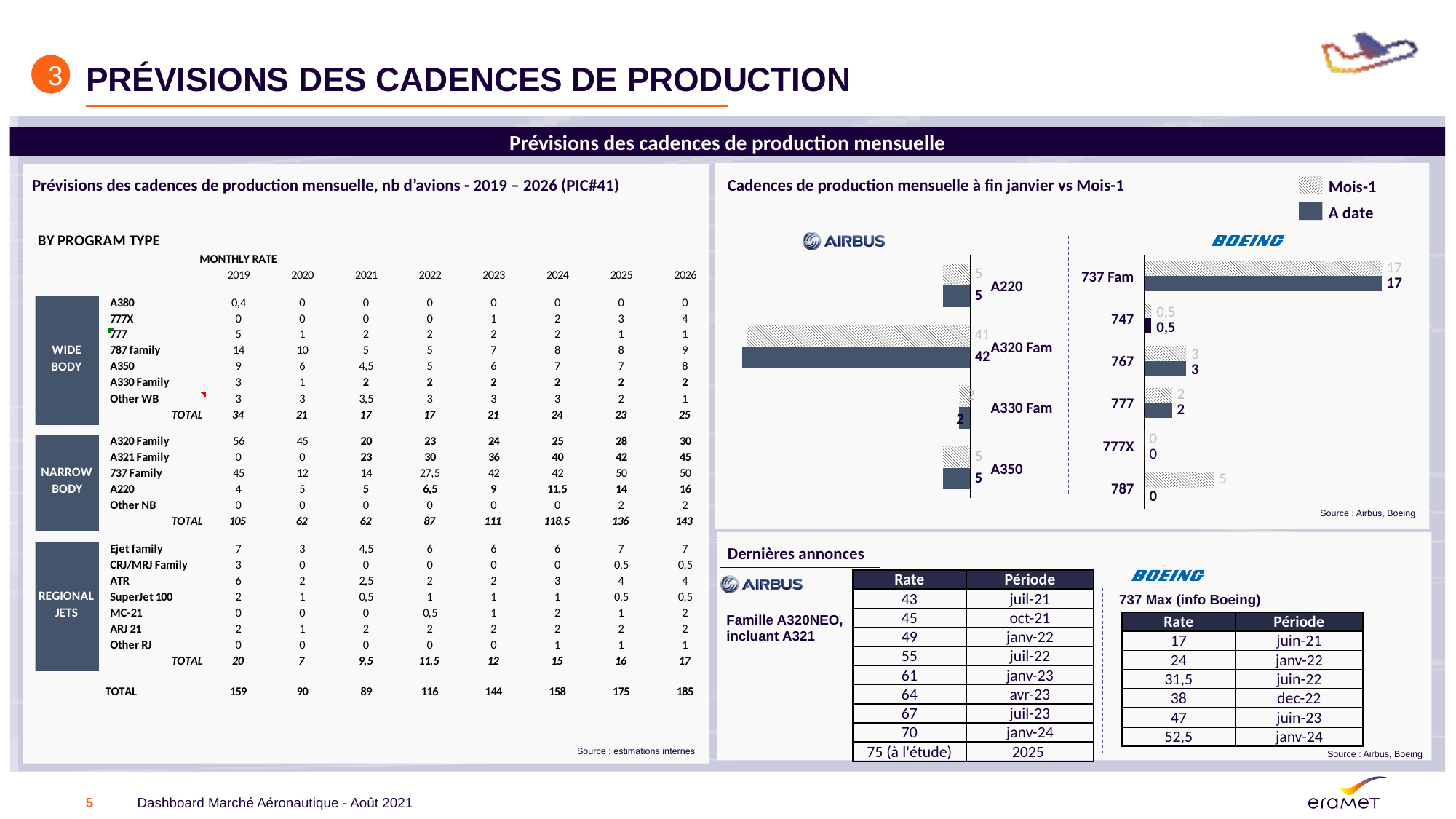
In the chart 'Cadences de production mensuelle à fin janvier vs Mois-1', how many series does the legend list? 2 In the chart 'Cadences de production mensuelle à fin janvier vs Mois-1', what is the 'A date' value for A320 Fam? 42 In the chart 'Cadences de production mensuelle à fin janvier vs Mois-1', what is the 'A date' value for 737 Fam? 17 In the chart 'Cadences de production mensuelle à fin janvier vs Mois-1', how many Boeing programs are shown? 6 In the chart 'Cadences de production mensuelle à fin janvier vs Mois-1', what is the difference between the 'A date' and 'Mois-1' values for A320 Fam? 1 In the chart 'Cadences de production mensuelle à fin janvier vs Mois-1', what is the 'Mois-1' value for 787? 5 In the chart 'Cadences de production mensuelle à fin janvier vs Mois-1', what is the 'Mois-1' value for A320 Fam? 41 In the chart 'Cadences de production mensuelle à fin janvier vs Mois-1', what is the 'A date' value for 787? 0 In the chart 'Cadences de production mensuelle à fin janvier vs Mois-1', which Airbus program has the highest 'A date' value? A320 Fam In the chart 'Cadences de production mensuelle à fin janvier vs Mois-1', what is the 'A date' value for 747? 0,5 In the chart 'Cadences de production mensuelle à fin janvier vs Mois-1', what kind of chart is used? Bar chart In the chart 'Cadences de production mensuelle à fin janvier vs Mois-1', which Boeing program has the highest 'A date' value? 737 Fam